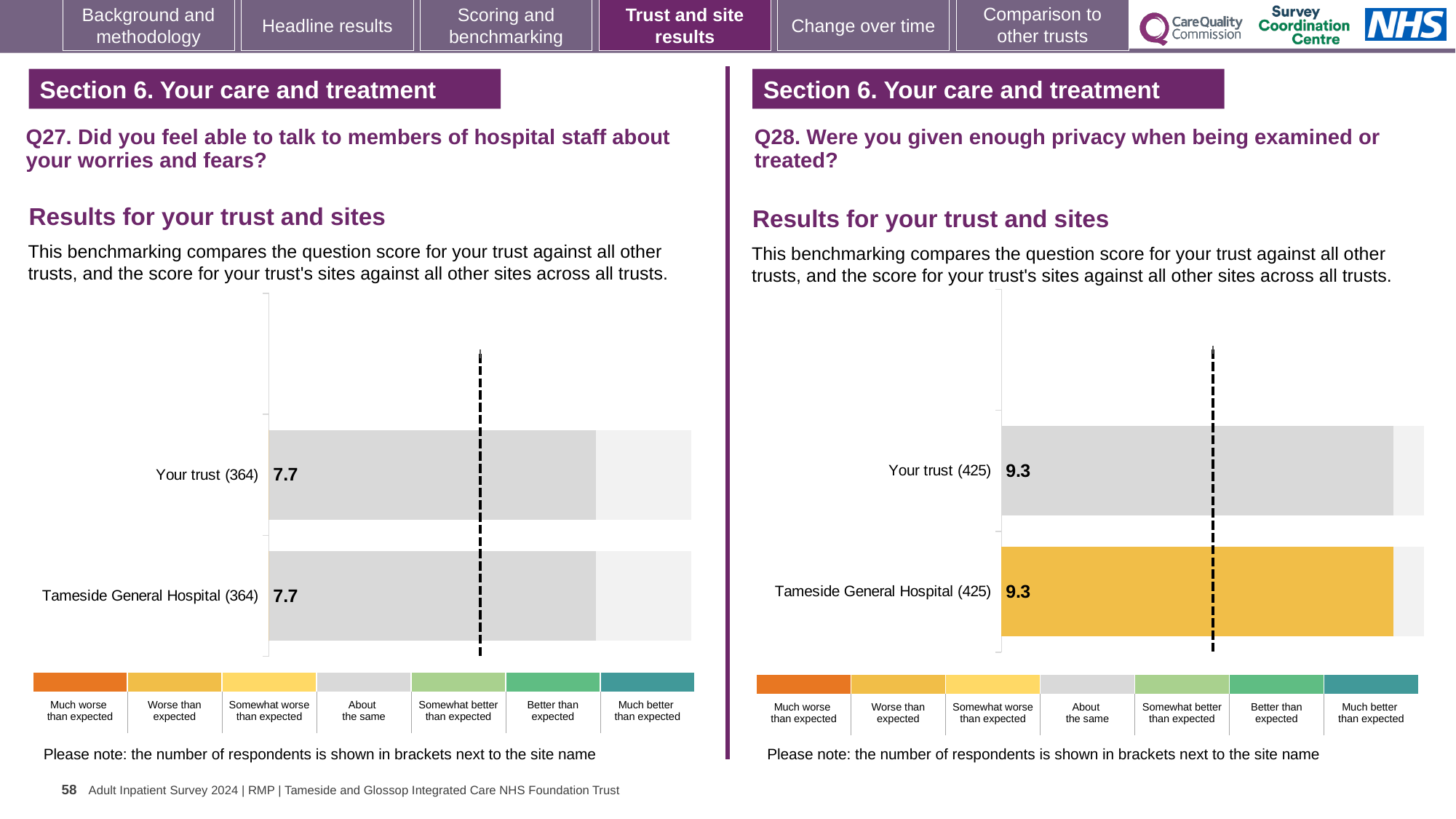
What kind of chart is the Q27 chart on the left? Bar chart In the Q27 chart on the left, what is the difference between the score for Your trust and the score for Tameside General Hospital? 0.0 In the Q28 chart on the right, what is the score for Your trust? 9.3 In the Q27 chart on the left, how many respondents are shown in brackets for Your trust? 364 How many bars are plotted in the Q27 chart on the left? 2 How many bars are plotted in the Q28 chart on the right? 2 In the Q28 chart on the right, what is the difference between the score for Your trust and the score for Tameside General Hospital? 0.0 In the Q28 chart on the right, which benchmark category does the colour of the Tameside General Hospital bar correspond to in the legend? Worse than expected In the Q27 chart on the left, what is the score for Your trust? 7.7 In the Q28 chart on the right, how many respondents are shown in brackets for Tameside General Hospital? 425 In the Q27 chart on the left, what is the score for Tameside General Hospital? 7.7 In the Q28 chart on the right, what is the score for Tameside General Hospital? 9.3